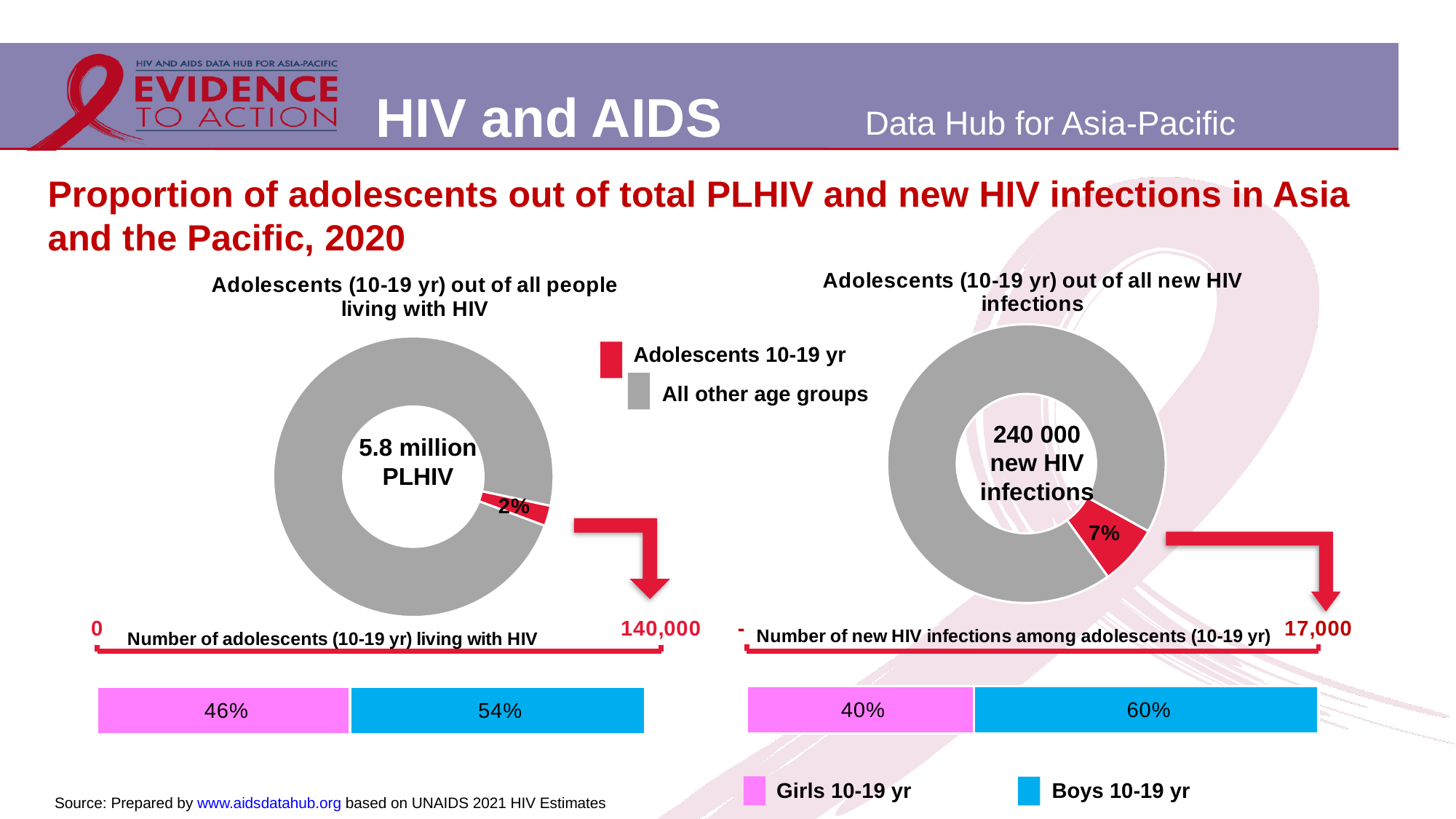
What kind of chart is used to show adolescents out of all people living with HIV? Donut (pie) chart In the left stacked bar showing adolescents (10-19 yr) living with HIV, what percentage is Boys 10-19 yr? 54% What total is printed in the centre of the right donut chart? 240 000 new HIV infections What number of new HIV infections among adolescents (10-19 yr) is printed at the end of the right-hand scale? 17,000 In the right stacked bar showing new HIV infections among adolescents (10-19 yr), what percentage is Boys 10-19 yr? 60% How many categories does the legend of the donut charts list? 2 What total is printed in the centre of the left donut chart? 5.8 million PLHIV In the donut chart titled 'Adolescents (10-19 yr) out of all new HIV infections', what share of the total do adolescents 10-19 yr make up? 7% In the right stacked bar showing new HIV infections among adolescents (10-19 yr), what is the difference between the Boys 10-19 yr share and the Girls 10-19 yr share? 20% In the left stacked bar showing adolescents (10-19 yr) living with HIV, what percentage is Girls 10-19 yr? 46% In the donut chart titled 'Adolescents (10-19 yr) out of all people living with HIV', what share of the total do adolescents 10-19 yr make up? 2% In the right stacked bar showing new HIV infections among adolescents (10-19 yr), which is larger, the Girls 10-19 yr share or the Boys 10-19 yr share? Boys 10-19 yr